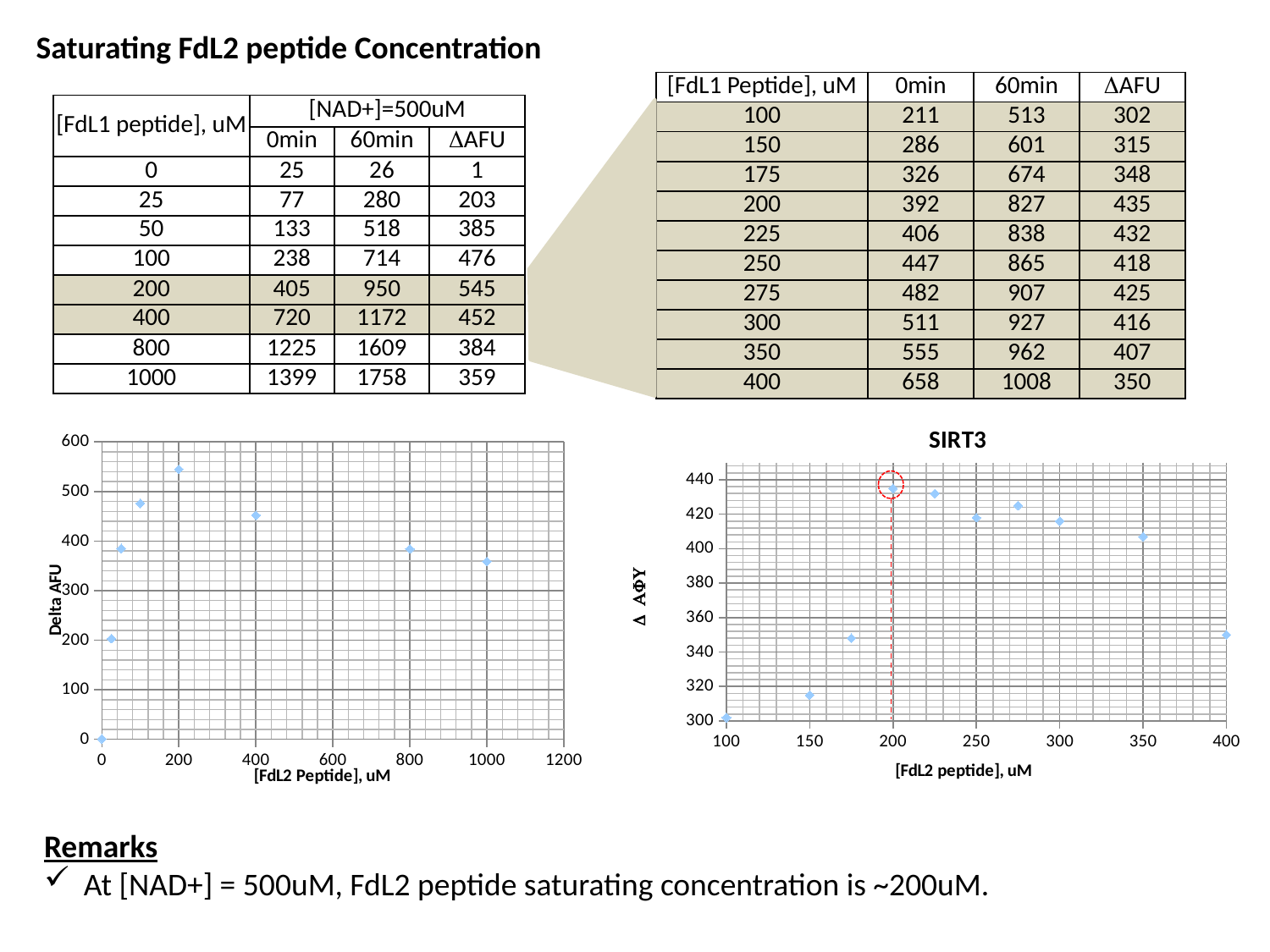
On the SIRT3 chart, at which peptide concentration is the Δ AFU value lowest? 100 On the left chart (Delta AFU vs [FdL2 Peptide], uM), at which peptide concentration is Delta AFU lowest? 0 On the SIRT3 chart, how many data points are plotted? 10 What is the title of the right chart? SIRT3 On the SIRT3 chart, which has the larger Δ AFU: 100 uM or 400 uM? 400 uM On the left chart (Delta AFU vs [FdL2 Peptide], uM), at which peptide concentration is Delta AFU highest? 200 On the SIRT3 chart, is the Δ AFU value at 400 uM greater or less than 360? less What kind of chart is the left chart (Delta AFU vs [FdL2 Peptide], uM)? scatter chart On the left chart (Delta AFU vs [FdL2 Peptide], uM), which has the larger Delta AFU: 200 uM or 400 uM? 200 uM On the left chart (Delta AFU vs [FdL2 Peptide], uM), how many data points are plotted? 8 On the left chart (Delta AFU vs [FdL2 Peptide], uM), is the Delta AFU value at 1000 uM greater or less than 400? less On the left chart (Delta AFU vs [FdL2 Peptide], uM), is the Delta AFU value at 200 uM greater or less than 500? greater